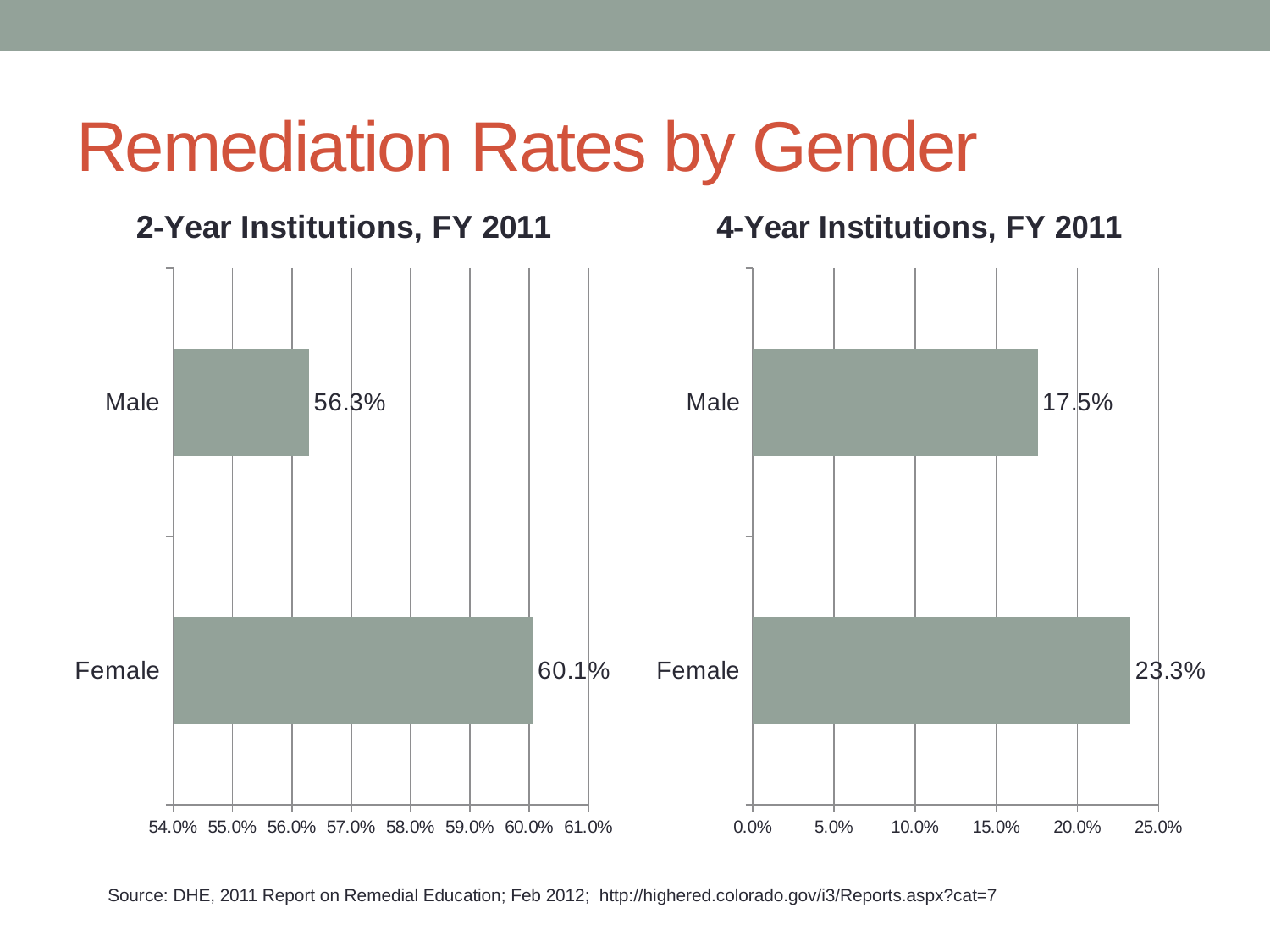
In the 2-Year Institutions, FY 2011 chart, which category has the higher remediation rate? Female In the 2-Year Institutions, FY 2011 chart, what is the remediation rate for Female? 60.1% In the 2-Year Institutions, FY 2011 chart, what is the difference between the Female and Male remediation rates? 3.8% What is the title of the slide containing the two charts? Remediation Rates by Gender In the 4-Year Institutions, FY 2011 chart, what is the remediation rate for Female? 23.3% In the 4-Year Institutions, FY 2011 chart, is the value for Female greater or less than 20.0%? greater In the 2-Year Institutions, FY 2011 chart, what is the remediation rate for Male? 56.3% In the 4-Year Institutions, FY 2011 chart, what is the difference between the Female and Male remediation rates? 5.8% In the 4-Year Institutions, FY 2011 chart, which category has the lower remediation rate? Male How many categories are shown in the 2-Year Institutions, FY 2011 chart? 2 What kind of chart is the 4-Year Institutions, FY 2011 chart? Bar chart In the 4-Year Institutions, FY 2011 chart, what is the remediation rate for Male? 17.5%